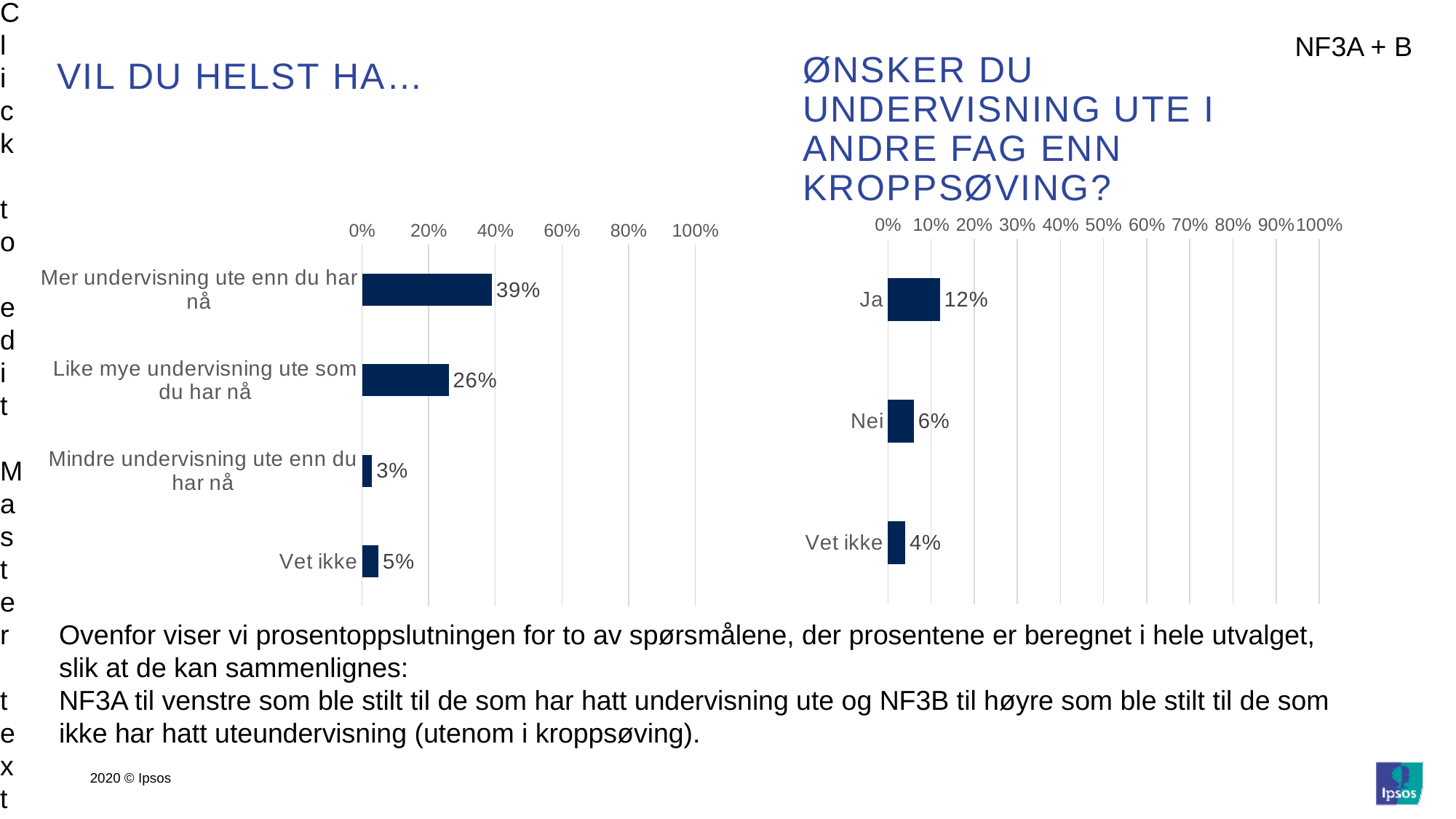
In the right chart 'ØNSKER DU UNDERVISNING UTE I ANDRE FAG ENN KROPPSØVING?', what is the value for 'Ja'? 12% What kind of chart is the right chart 'ØNSKER DU UNDERVISNING UTE I ANDRE FAG ENN KROPPSØVING?'? Bar chart In the right chart 'ØNSKER DU UNDERVISNING UTE I ANDRE FAG ENN KROPPSØVING?', which category has the highest value? Ja In the right chart 'ØNSKER DU UNDERVISNING UTE I ANDRE FAG ENN KROPPSØVING?', what is the value for 'Nei'? 6% In the left chart 'VIL DU HELST HA…', what is the value for 'Like mye undervisning ute som du har nå'? 26% In the left chart 'VIL DU HELST HA…', which category has the lowest value? Mindre undervisning ute enn du har nå In the left chart 'VIL DU HELST HA…', what is the value for 'Mer undervisning ute enn du har nå'? 39% In the right chart 'ØNSKER DU UNDERVISNING UTE I ANDRE FAG ENN KROPPSØVING?', which is larger, 'Nei' or 'Vet ikke'? Nei In the left chart 'VIL DU HELST HA…', how many categories are shown? 4 In the left chart 'VIL DU HELST HA…', what is the difference between 'Mer undervisning ute enn du har nå' and 'Like mye undervisning ute som du har nå'? 13% In the right chart 'ØNSKER DU UNDERVISNING UTE I ANDRE FAG ENN KROPPSØVING?', what is the difference between 'Ja' and 'Nei'? 6% In the left chart 'VIL DU HELST HA…', is the value for 'Mer undervisning ute enn du har nå' greater or less than 20%? greater